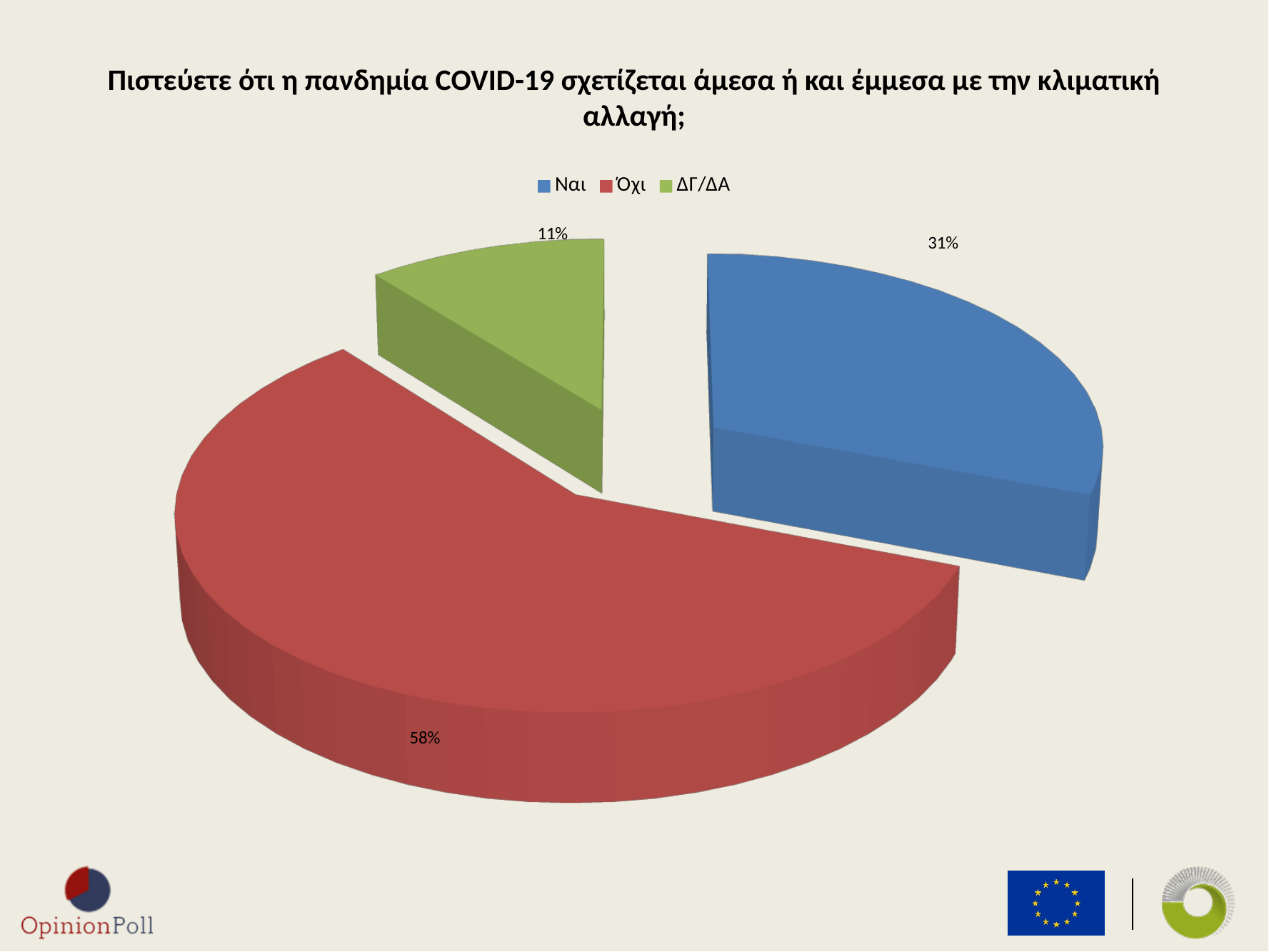
Which response has the smallest share of the pie? ΔΓ/ΔΑ What is the difference in percentage points between Ναι and ΔΓ/ΔΑ? 20 What percentage of respondents answered ΔΓ/ΔΑ? 11% What percentage of respondents answered Ναι? 31% What kind of chart is shown on the slide? Pie chart Which response has the largest share of the pie? Όχι What colour is the slice for Όχι? Red What is the difference in percentage points between Όχι and Ναι? 27 How many slices does the pie chart have? 3 Which is larger, the share for Ναι or the share for ΔΓ/ΔΑ? Ναι What percentage of respondents answered Όχι? 58% How many entries does the legend list? 3